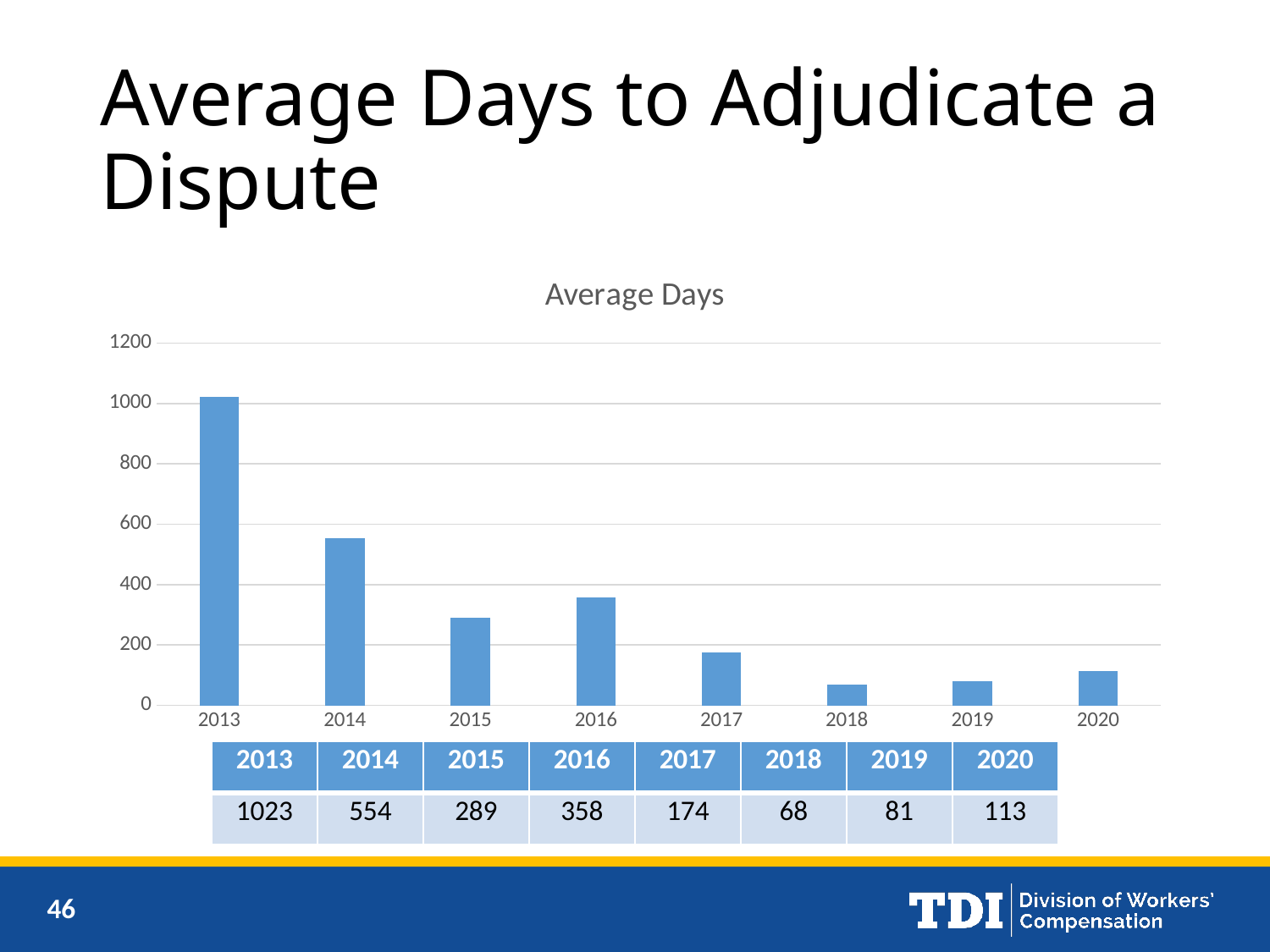
What is the average number of days to adjudicate a dispute in 2020? 113 What is the title of the chart? Average Days Which year has a higher average days value, 2015 or 2016? 2016 What is the difference in average days between 2016 and 2015? 69 What is the average number of days to adjudicate a dispute in 2013? 1023 Which year has the lowest average days to adjudicate a dispute? 2018 How many years are shown on the chart? 8 Which year has the highest average days to adjudicate a dispute? 2013 What is the difference in average days between 2013 and 2014? 469 What type of chart is shown on the slide? Bar chart Is the value for 2014 greater or less than 400? greater What is the average number of days to adjudicate a dispute in 2018? 68